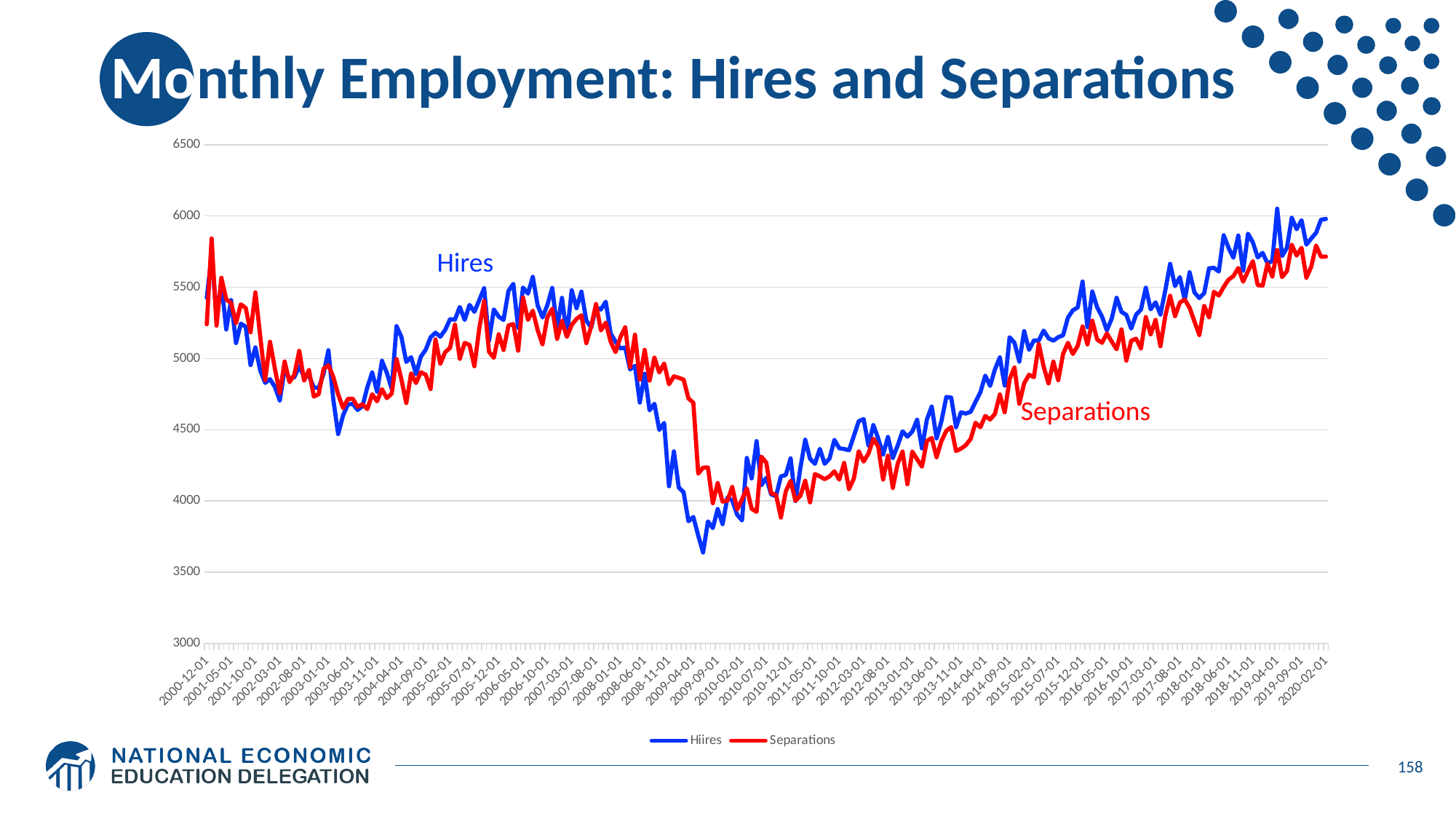
Do the Hires values generally rise or fall between 2007-08-01 and 2009-09-01? Fall At 2020-02-01, which line is higher, Hires or Separations? Hires Which colour is used for the Separations line? Red Is the value of the Hires line at 2020-02-01 greater or less than 5500? greater At 2009-04-01, which line is higher, Hires or Separations? Separations Is the value of the Separations line at 2020-02-01 greater or less than 5500? greater How many series does the legend list? 2 Is the value of the Separations line at 2008-01-01 greater or less than 5000? greater What kind of chart is shown on the slide? Line chart Do the Hires values generally rise or fall between 2009-09-01 and 2020-02-01? Rise What is the title of the chart on the slide? Monthly Employment: Hires and Separations